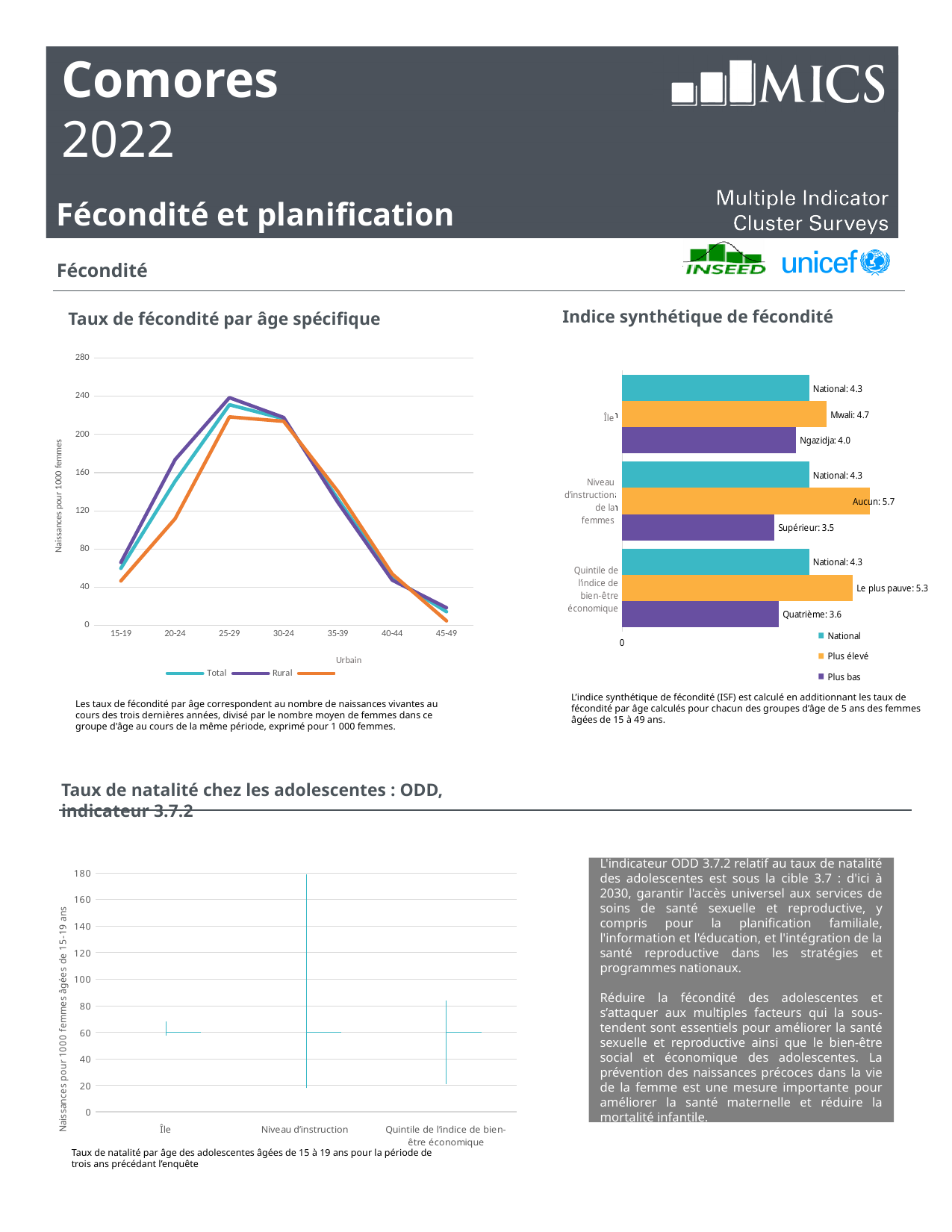
In the 'Indice synthétique de fécondité' chart, which is larger, the value for Le plus pauvre or the value for Quatrième? Le plus pauvre In the 'Indice synthétique de fécondité' chart, which labelled bar has the highest value? Aucun: 5.7 How many age groups are shown on the x axis of the 'Taux de fécondité par âge spécifique' chart? 7 How many series does the legend of the 'Indice synthétique de fécondité' chart list? 3 In the 'Indice synthétique de fécondité' chart, what is the value for Le plus pauvre? 5.3 In the 'Indice synthétique de fécondité' chart, what is the difference between the values for Mwali and Ngazidja? 0.7 In the 'Indice synthétique de fécondité' chart, what is the value for Mwali? 4.7 In the 'Indice synthétique de fécondité' chart, what is the National value? 4.3 In the 'Taux de fécondité par âge spécifique' chart, is the Rural value for the 25-29 age group greater or less than 200? greater In the 'Indice synthétique de fécondité' chart, what is the value for Aucun (no education)? 5.7 What kind of chart is 'Taux de fécondité par âge spécifique'? Line chart In the 'Indice synthétique de fécondité' chart, which labelled bar has the lowest value? Supérieur: 3.5